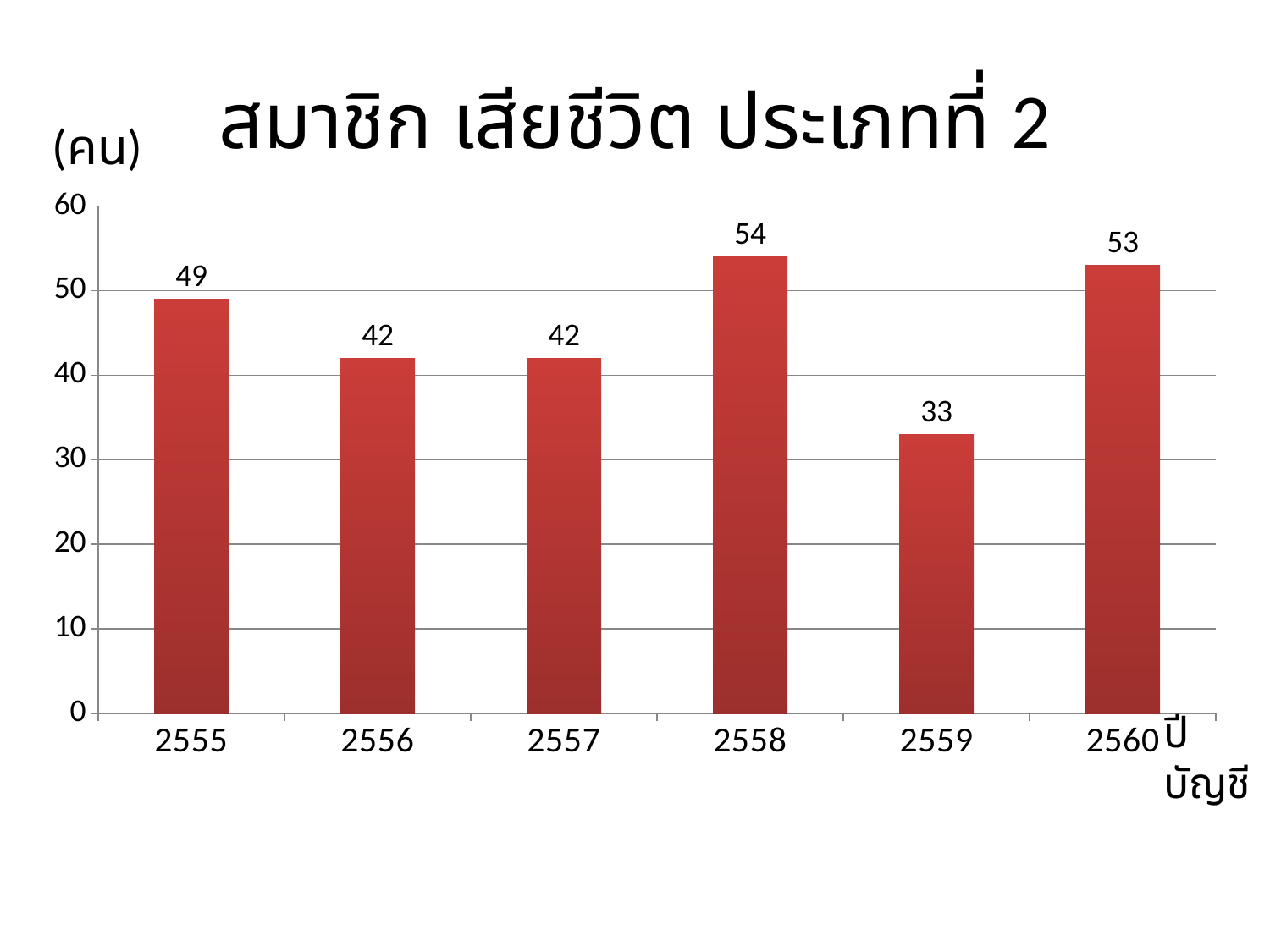
What is the value for 2559? 33 What is the difference between the values for 2558 and 2559? 21 Which is larger, the value for 2555 or the value for 2557? 2555 What is the title of the chart? สมาชิก เสียชีวิต ประเภทที่ 2 What is the value for 2555? 49 Which year has the highest value? 2558 What is the difference between the values for 2555 and 2556? 7 How many years are shown on the x axis? 6 Which year has the lowest value? 2559 Is the value for 2559 greater or less than 40? less What is the value for 2560? 53 What kind of chart is this? bar chart